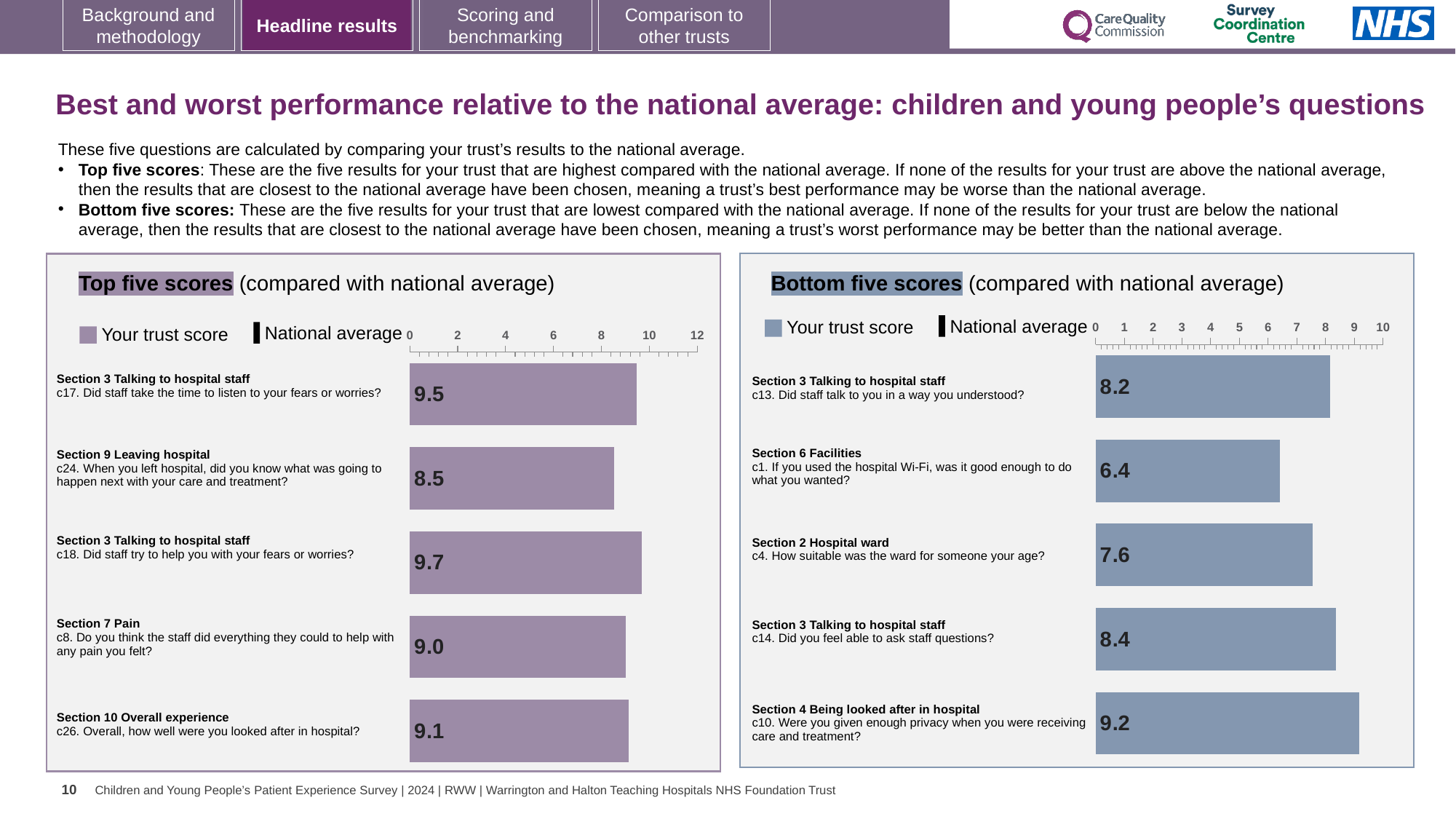
In the Top five scores chart, what is the trust score for c24 (When you left hospital, did you know what was going to happen next with your care and treatment)? 8.5 What type of chart is the Top five scores chart? Bar chart In the Bottom five scores chart, which question has the highest trust score? c10. Were you given enough privacy when you were receiving care and treatment? In the Top five scores chart, which question has the highest trust score? c18. Did staff try to help you with your fears or worries? In the Bottom five scores chart, which question has the lowest trust score? c1. If you used the hospital Wi-Fi, was it good enough to do what you wanted? In the Top five scores chart, what is the trust score for c17 (Did staff take the time to listen to your fears or worries)? 9.5 In the Top five scores chart, what is the difference between the trust scores for c18 and c8? 0.7 In the Top five scores chart, which question has the lowest trust score? c24. When you left hospital, did you know what was going to happen next with your care and treatment? How many questions are shown in the Bottom five scores chart? 5 In the Bottom five scores chart, what is the trust score for c4 (How suitable was the ward for someone your age)? 7.6 In the Bottom five scores chart, what is the trust score for c1 (If you used the hospital Wi-Fi, was it good enough to do what you wanted)? 6.4 In the Bottom five scores chart, which has the larger trust score: c13 or c14? c14